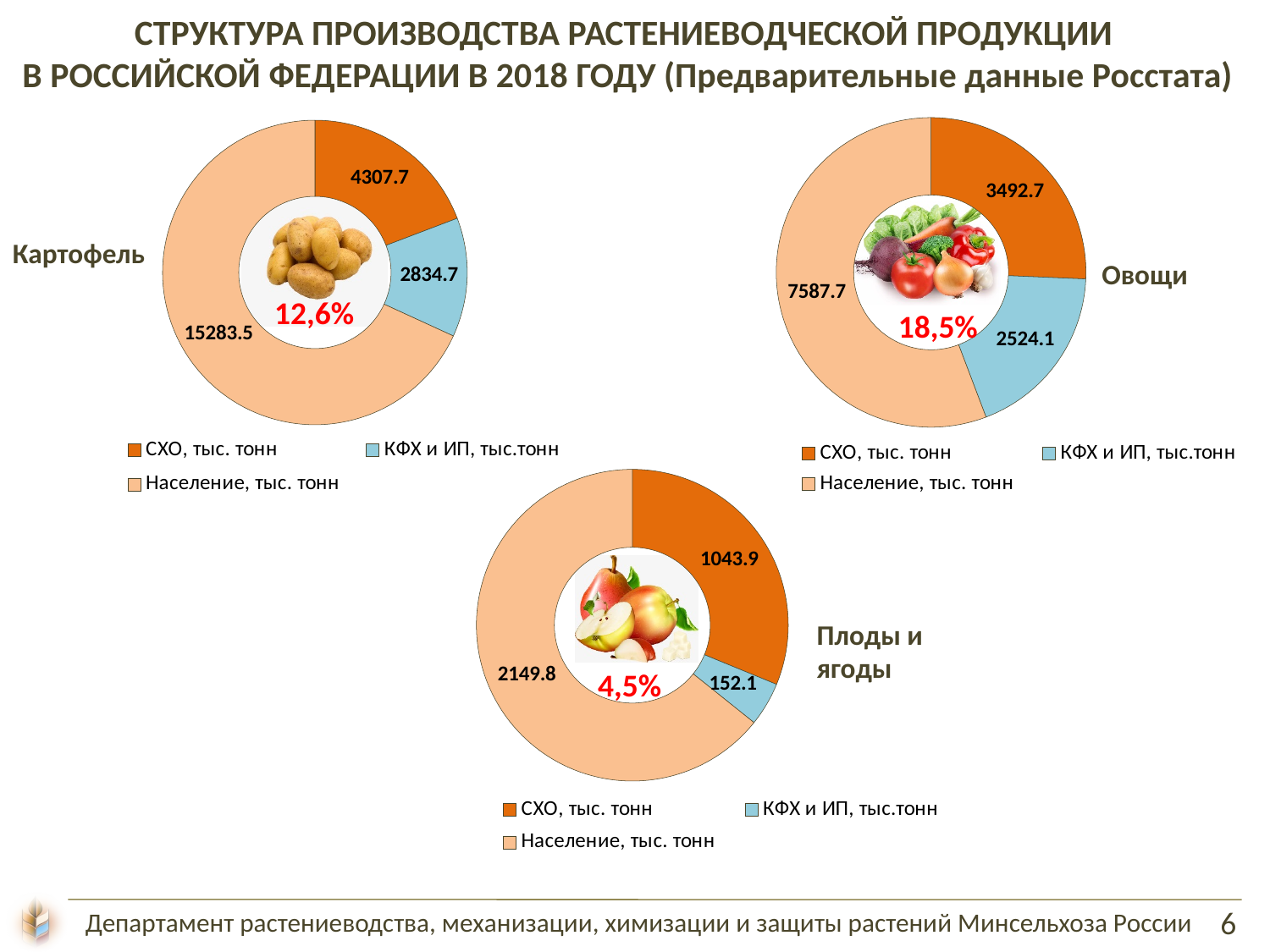
In the Картофель chart, what is the value for Население, тыс. тонн? 15283.5 In the Плоды и ягоды chart, what is the difference between Население and СХО? 1105.9 In the Картофель chart, which category has the smallest value? КФХ и ИП, тыс.тонн How many doughnut charts are shown on the slide? 3 In the Картофель chart, what is the total of all three segments? 22425.9 In the Овощи chart, which category has the largest value? Население, тыс. тонн What kind of chart is the Плоды и ягоды chart? doughnut (pie) chart In the Овощи chart, what is the value for СХО, тыс. тонн? 3492.7 In the Овощи chart, what share of the total does КФХ и ИП account for, as printed in the centre? 18,5% How many series does the legend of the Картофель chart list? 3 In the Овощи chart, which is larger: СХО or КФХ и ИП? СХО, тыс. тонн In the Плоды и ягоды chart, what is the value for КФХ и ИП, тыс.тонн? 152.1